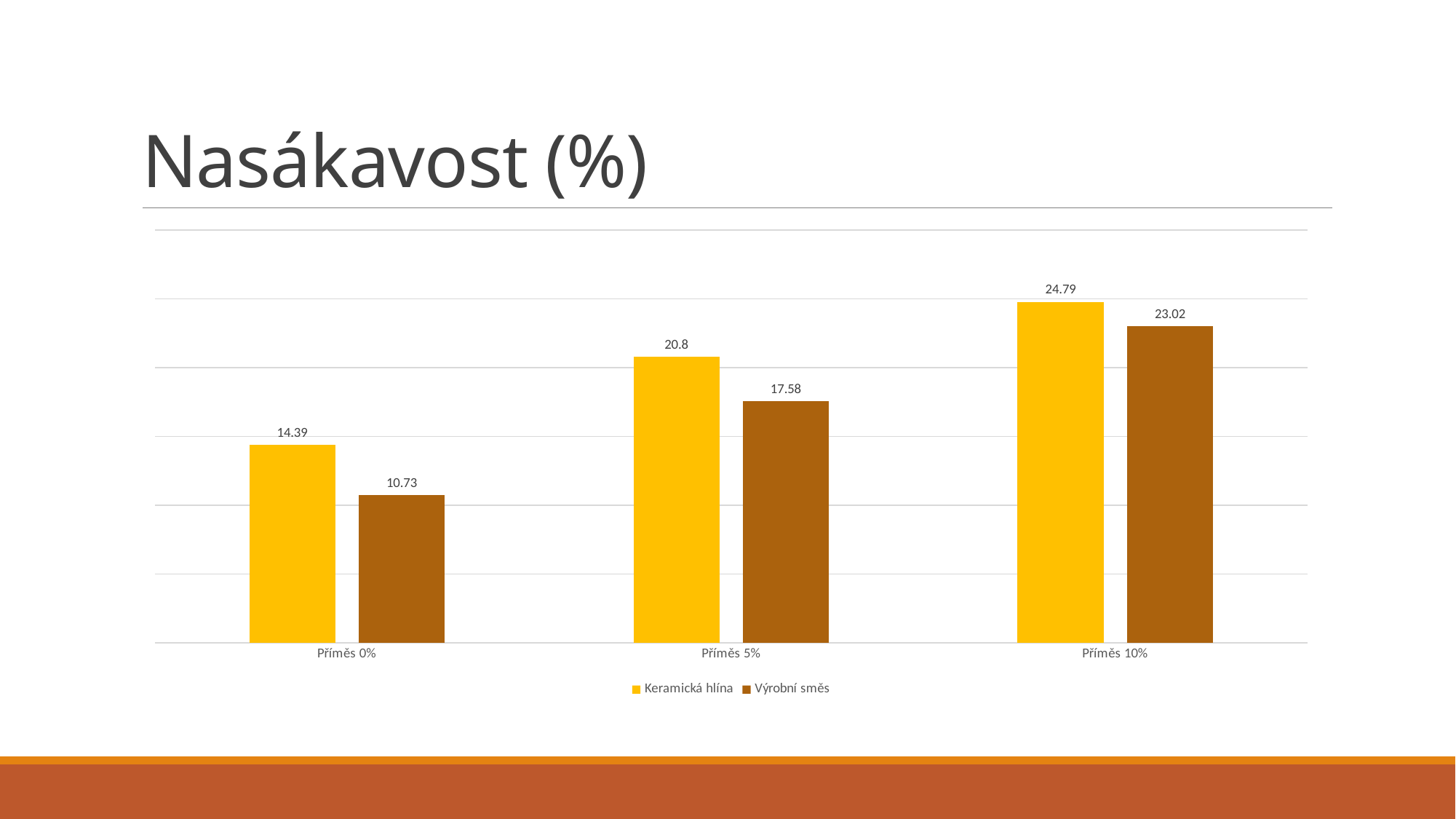
How many categories are shown on the x axis? 3 What is the value for Výrobní směs at Příměs 5%? 17.58 What is the value for Výrobní směs at Příměs 10%? 23.02 Do the values for Výrobní směs rise or fall from Příměs 0% to Příměs 10%? Rise What kind of chart is shown on the slide? Bar chart Which category has the lowest value for Výrobní směs? Příměs 0% What is the difference between Keramická hlína and Výrobní směs at Příměs 0%? 3.66 What is the difference between Keramická hlína at Příměs 10% and at Příměs 5%? 3.99 Which is larger at Příměs 5%: Keramická hlína or Výrobní směs? Keramická hlína How many series does the legend list? 2 What is the value for Keramická hlína at Příměs 0%? 14.39 Which category has the highest value for Keramická hlína? Příměs 10%